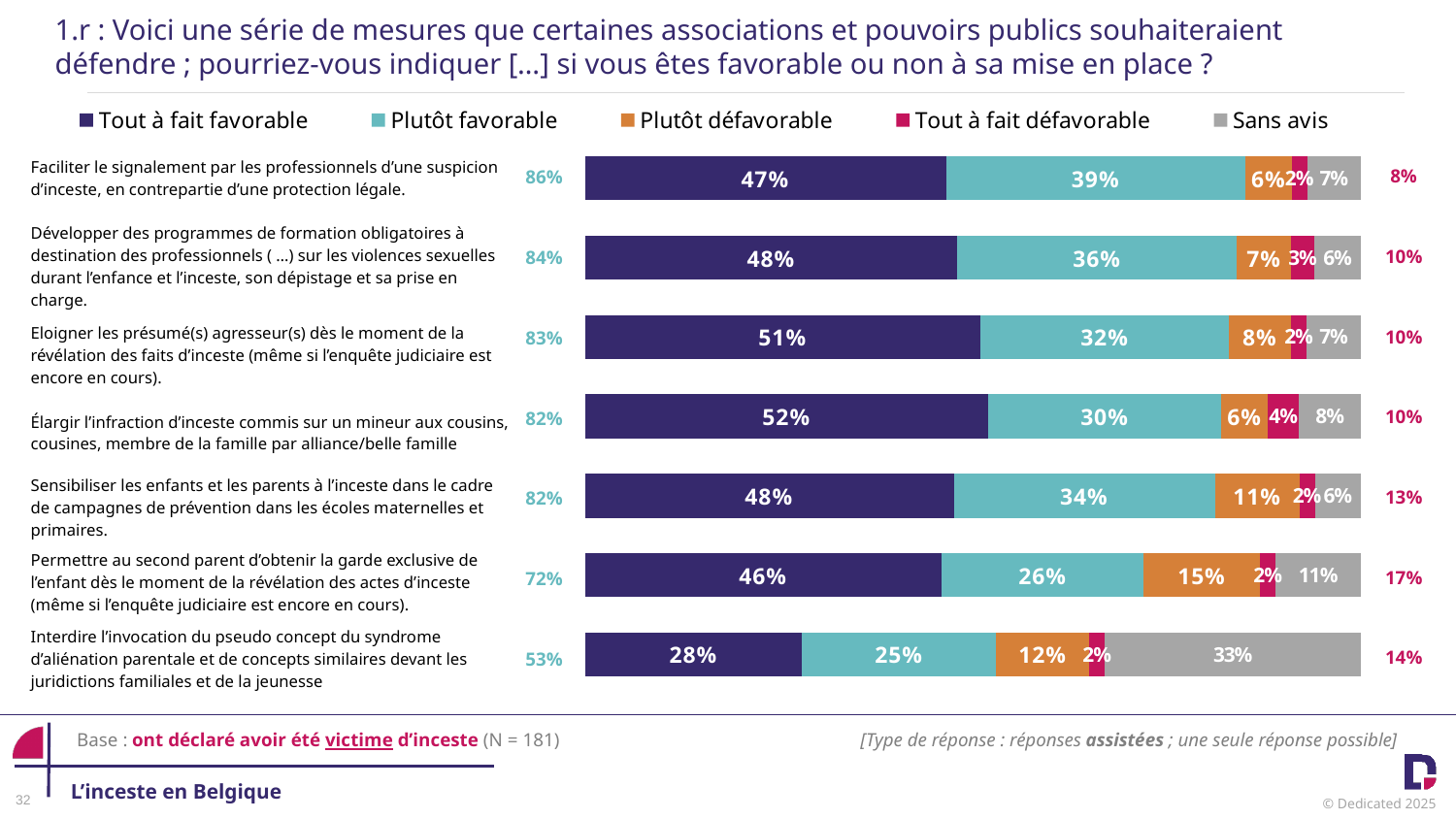
Which measure has the highest 'Tout à fait favorable' value? Élargir l'infraction d'inceste commis sur un mineur aux cousins, cousines, membre de la famille par alliance/belle famille Which legend entry is shown in grey? Sans avis Which is larger: the 'Plutôt favorable' value for 'Développer des programmes de formation obligatoires' or for 'Sensibiliser les enfants et les parents à l'inceste'? Développer des programmes de formation obligatoires How many series does the legend list? 5 What is the 'Tout à fait favorable' value for 'Eloigner les présumé(s) agresseur(s) dès le moment de la révélation des faits d'inceste'? 51% Which measure has the lowest 'Tout à fait favorable' value? Interdire l'invocation du pseudo concept du syndrome d'aliénation parentale et de concepts similaires devant les juridictions familiales et de la jeunesse How many measures (categories) are plotted in the chart? 7 What is the 'Plutôt défavorable' value for 'Permettre au second parent d'obtenir la garde exclusive de l'enfant'? 15% What kind of chart is shown on the slide? Stacked bar chart What is the 'Sans avis' value for 'Interdire l'invocation du pseudo concept du syndrome d'aliénation parentale'? 33% What is the combined total of 'Tout à fait favorable' and 'Plutôt favorable' for 'Faciliter le signalement par les professionnels d'une suspicion d'inceste'? 86% What is the difference between the 'Plutôt favorable' values for 'Faciliter le signalement par les professionnels' and 'Permettre au second parent d'obtenir la garde exclusive'? 13%